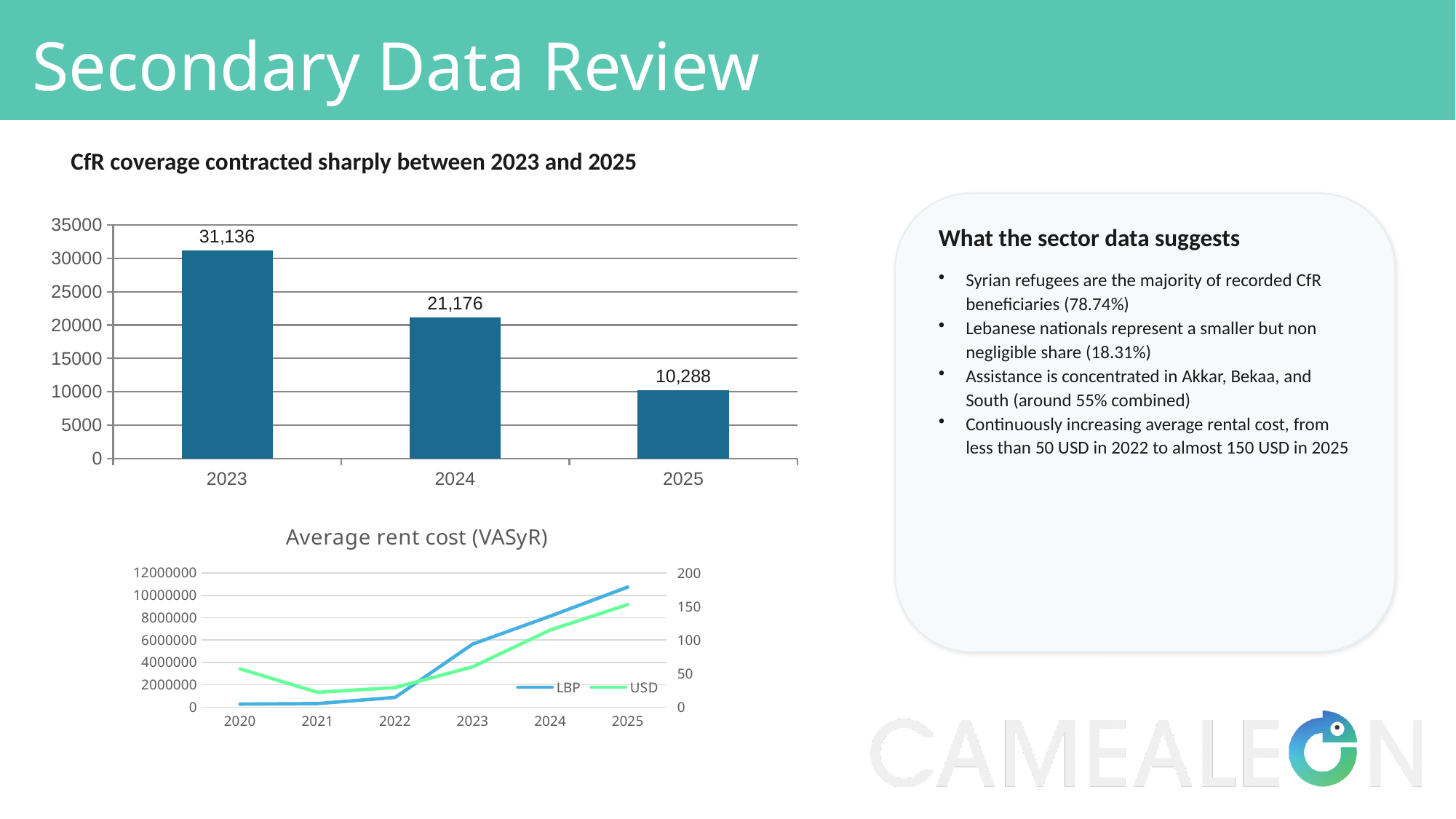
In the top bar chart, what is the value for 2024? 21,176 In the top bar chart, what is the value for 2023? 31,136 In the 'Average rent cost (VASyR)' chart, is the LBP value for 2025 greater or less than 10000000? greater In the top bar chart, what is the value for 2025? 10,288 In the top bar chart, which year has the lowest value? 2025 In the top bar chart, what is the difference between the 2023 and 2024 values? 9,960 What kind of chart is the 'Average rent cost (VASyR)' chart? line chart How many series does the legend of the 'Average rent cost (VASyR)' chart list? 2 In the 'Average rent cost (VASyR)' chart, how many years are shown on the x axis? 6 In the top bar chart, what is the difference between the 2023 and 2025 values? 20,848 In the top bar chart, which year has the highest value? 2023 In the top bar chart, do the values rise or fall from 2023 to 2025? fall